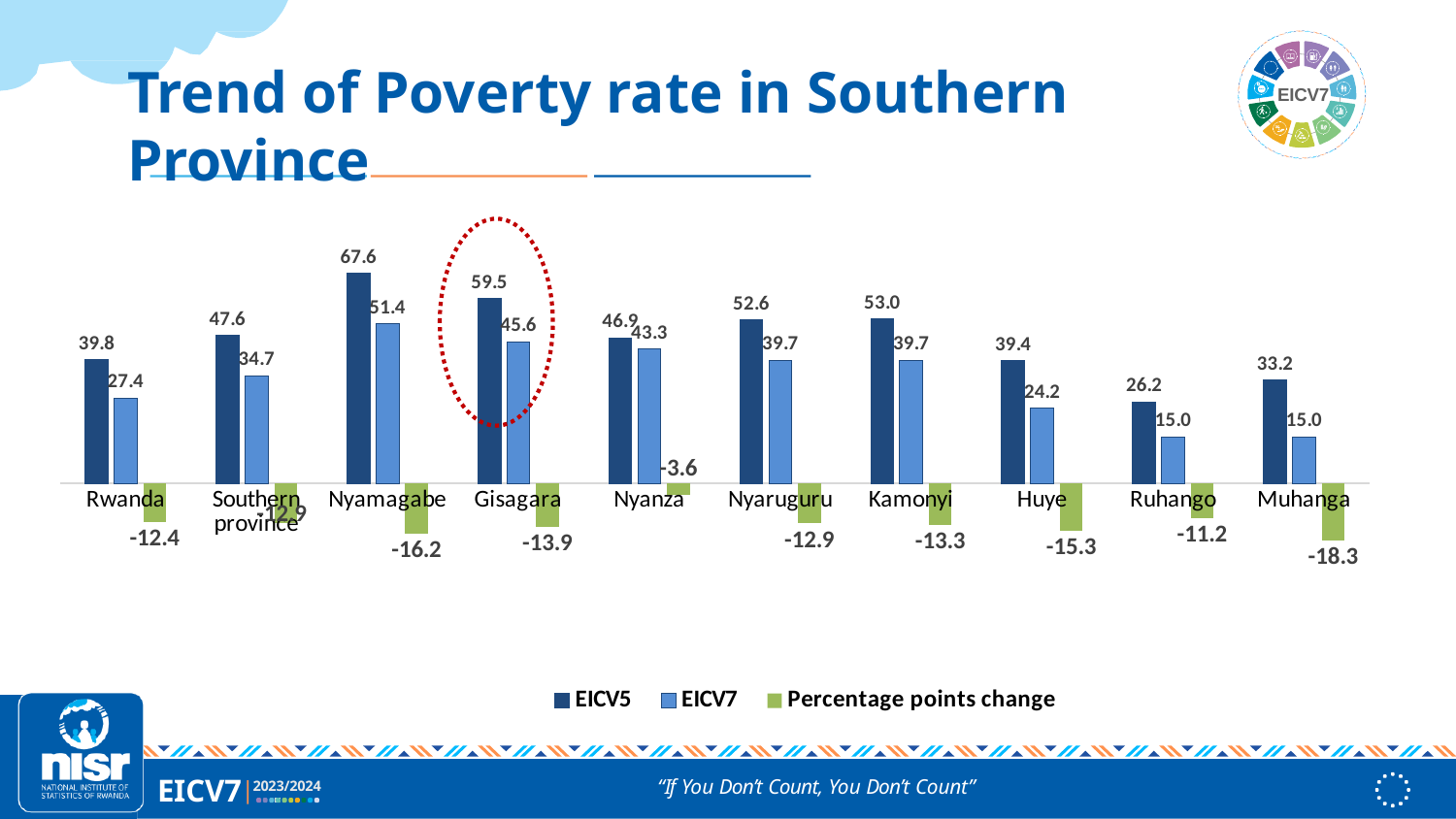
Which has the higher EICV7 poverty rate, Nyanza or Nyaruguru? Nyanza What is the difference between the EICV5 and EICV7 poverty rates for Huye? 15.2 What is the EICV5 poverty rate for Nyamagabe? 67.6 How many series does the legend list? 3 Which category has the highest EICV5 poverty rate? Nyamagabe How many categories are shown on the x axis of the chart? 10 What kind of chart is shown on the slide? Bar chart What is the EICV7 poverty rate for Gisagara? 45.6 Which category is highlighted with a red dotted circle? Gisagara What is the percentage points change for Nyanza? -3.6 Which category has the lowest EICV5 poverty rate? Ruhango What is the percentage points change for Muhanga? -18.3